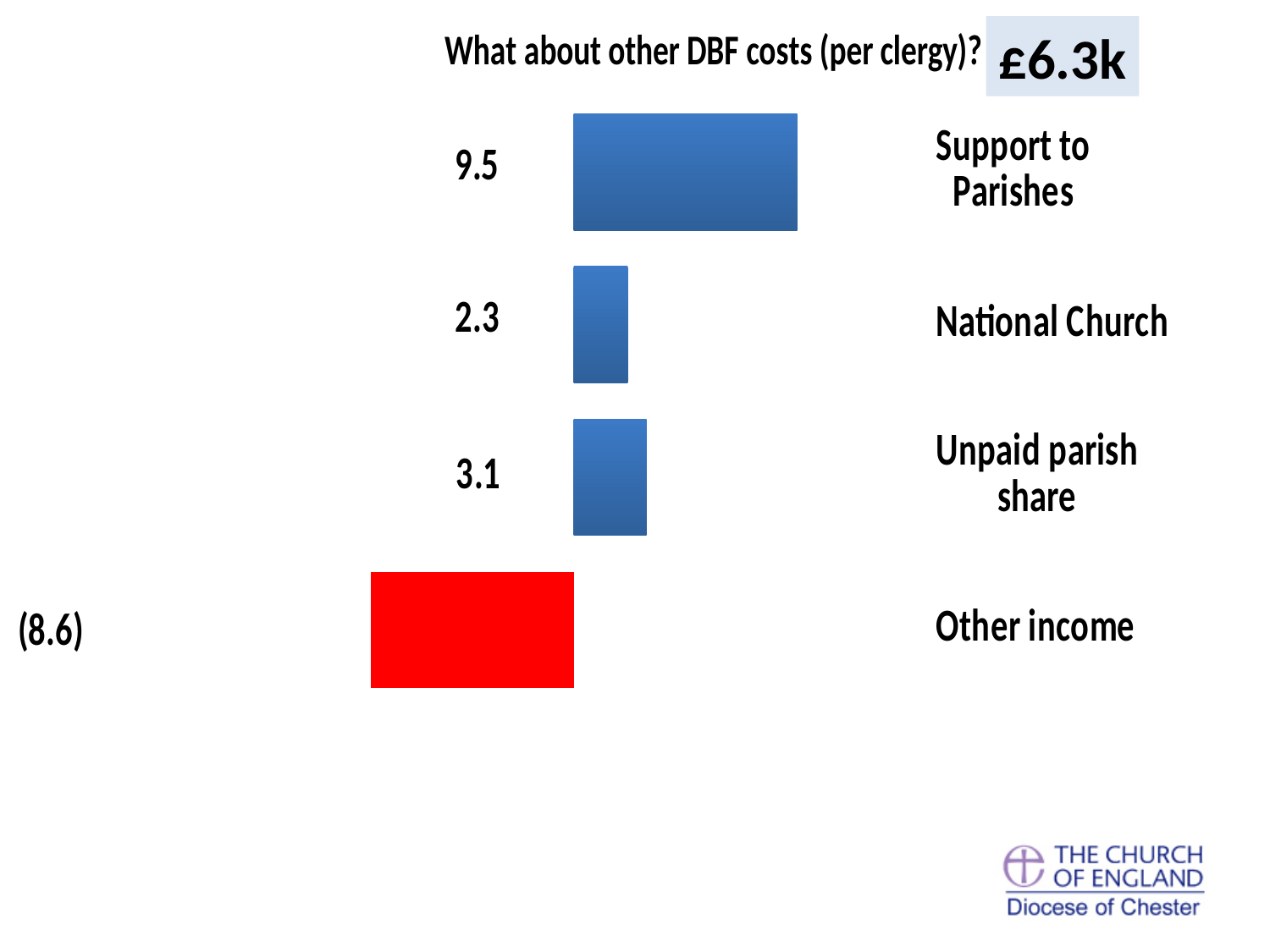
Which category has the smallest positive value? National Church How many categories are shown in the chart? 4 Which category is drawn with a red bar? Other income Which category has the largest positive bar? Support to Parishes What is the value shown for Other income? (8.6) What is the value shown for Support to Parishes? 9.5 What is the difference between the values for Support to Parishes and Unpaid parish share? 6.4 What is the title of the chart? What about other DBF costs (per clergy)? What kind of chart is shown on the slide? Bar chart What is the value shown for National Church? 2.3 Which is larger, the value for Unpaid parish share or the value for National Church? Unpaid parish share What is the value shown for Unpaid parish share? 3.1